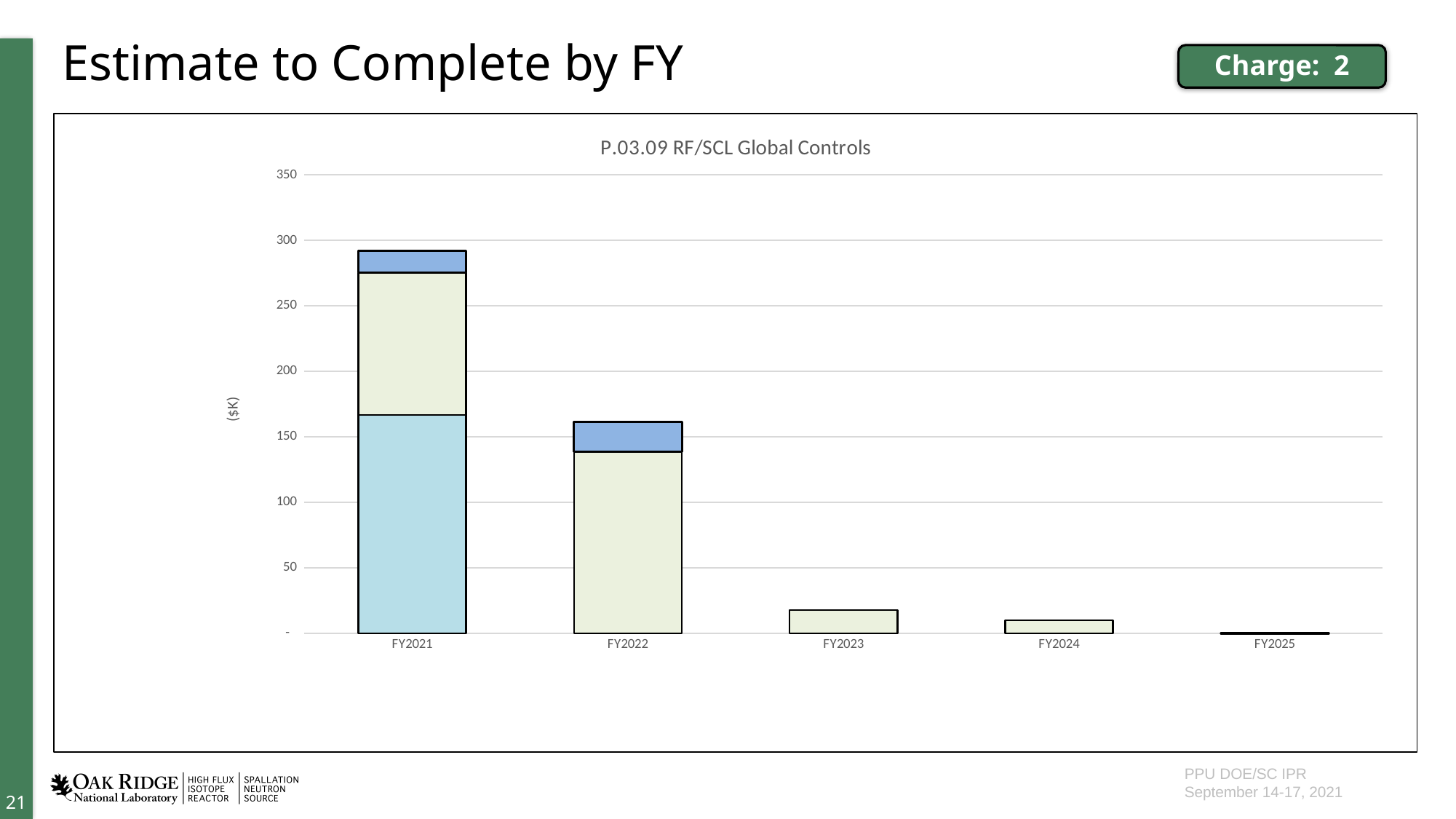
How many fiscal years are shown on the x axis of the chart? 5 Is the total value for FY2022 greater or less than 200? less Which bar is taller, FY2023 or FY2024? FY2023 What is the label on the vertical axis of the chart? ($K) Is the total value for FY2021 greater or less than 250? greater Which fiscal year has the shortest bar in the chart? FY2025 What is the title of the chart? P.03.09 RF/SCL Global Controls What kind of chart is shown on the slide? bar chart Do the bar totals rise or fall from FY2021 to FY2025? fall Which bar is taller, FY2021 or FY2022? FY2021 Is the total value for FY2023 greater or less than 50? less Which fiscal year has the tallest bar in the chart? FY2021